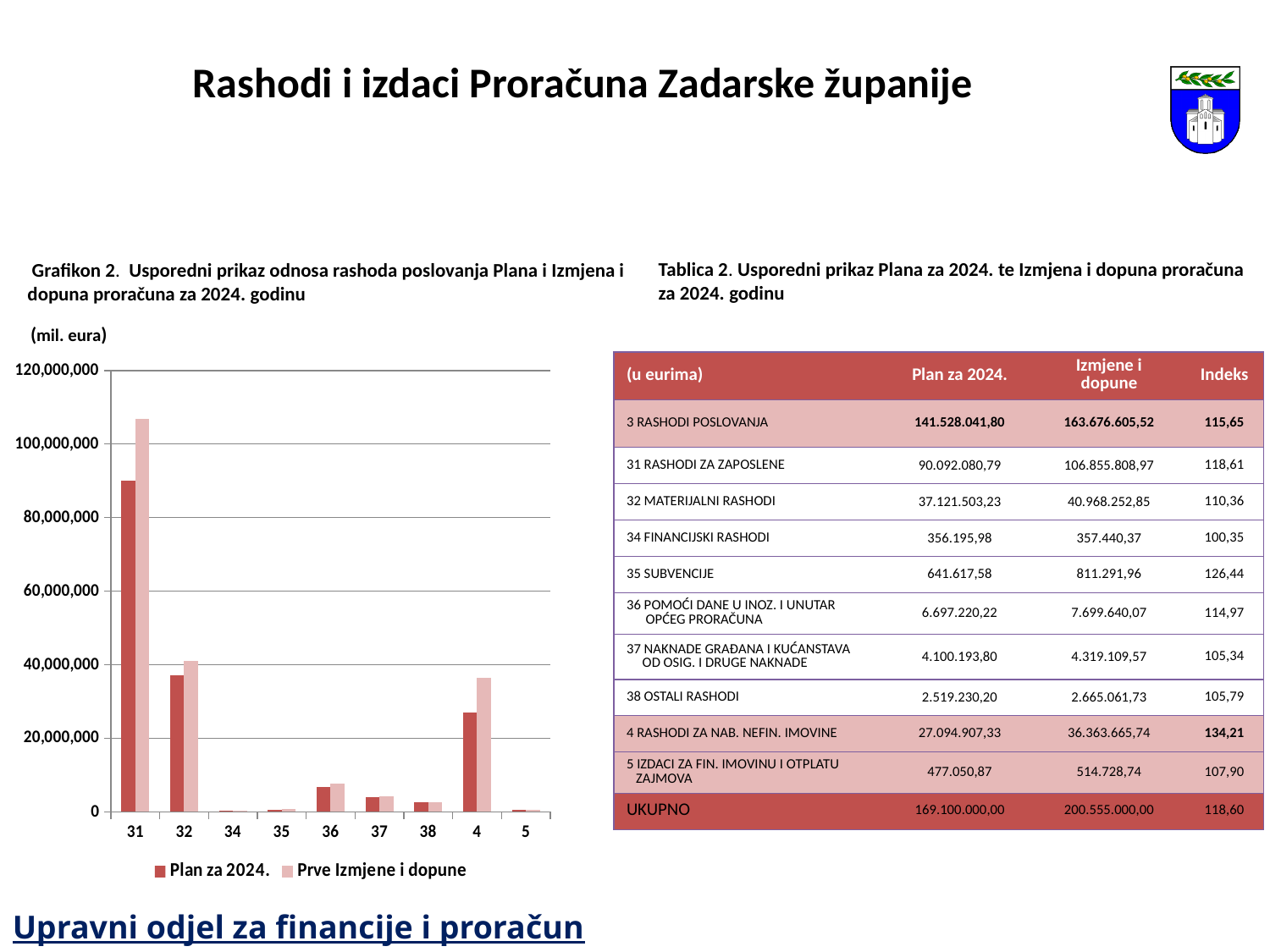
For category 4, which series has the larger bar: Plan za 2024. or Prve Izmjene i dopune? Prve Izmjene i dopune What kind of chart is Grafikon 2 on the slide? bar chart Is the Plan za 2024. value for category 32 greater or less than 40,000,000? less How many series does the chart's legend list? 2 Is the Prve Izmjene i dopune value for category 31 greater or less than 100,000,000? greater Which category has the highest Plan za 2024. bar in the chart? 31 What are the two series names listed in the chart's legend? Plan za 2024. and Prve Izmjene i dopune Is the Plan za 2024. value for category 31 greater or less than 80,000,000? greater How many categories are shown on the x axis of the chart? 9 Which category has the larger Plan za 2024. bar: 32 or 4? 32